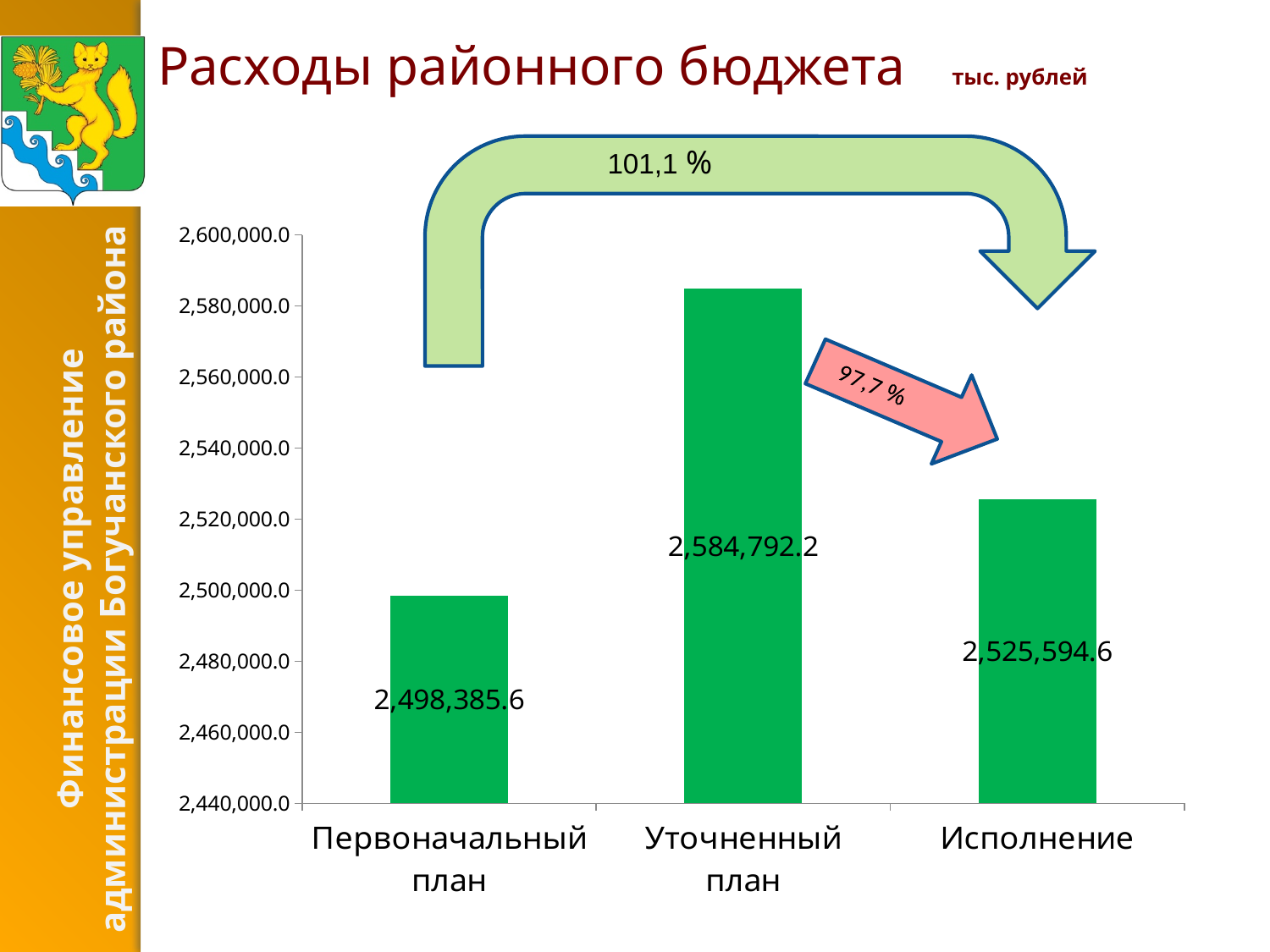
What is the title of the chart? Расходы районного бюджета How many categories are shown on the x axis? 3 Which category has the highest value? Уточненный план What is the value for Уточненный план? 2,584,792.2 What is the difference between Уточненный план and Исполнение? 59,197.6 Which category has the lowest value? Первоначальный план What kind of chart is shown on the slide? bar chart What is the value for Первоначальный план? 2,498,385.6 Is the value for Исполнение greater or less than 2,540,000.0? less What is the difference between Уточненный план and Первоначальный план? 86,406.6 Which is larger, Исполнение or Первоначальный план? Исполнение What is the value for Исполнение? 2,525,594.6